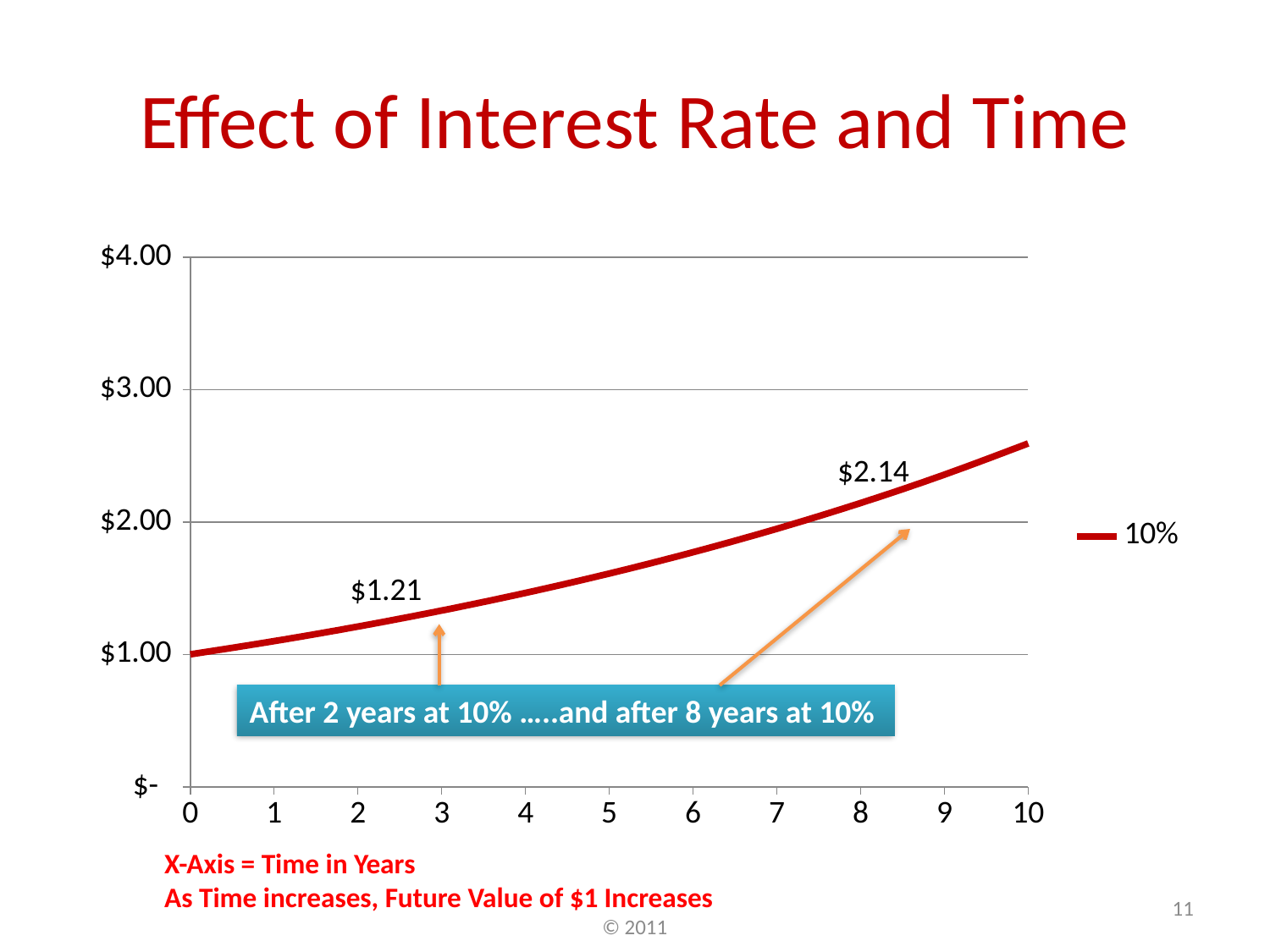
What is the difference between the labelled values at year 8 and year 2? $0.93 What is the labelled value of the 10% line at year 8? $2.14 Does the value rise or fall as the years increase along the x axis? Rise What is the title of the slide containing the chart? Effect of Interest Rate and Time Is the value at year 5 greater or less than $2.00? less What is the labelled value of the 10% line at year 2? $1.21 Is the value at year 10 greater or less than $3.00? less Which is larger, the value at year 8 or the value at year 2? Year 8 Is the value at year 10 greater or less than $2.00? greater How many series does the legend list? 1 What kind of chart is shown on the slide? Line chart What is the name of the series shown in the legend? 10%